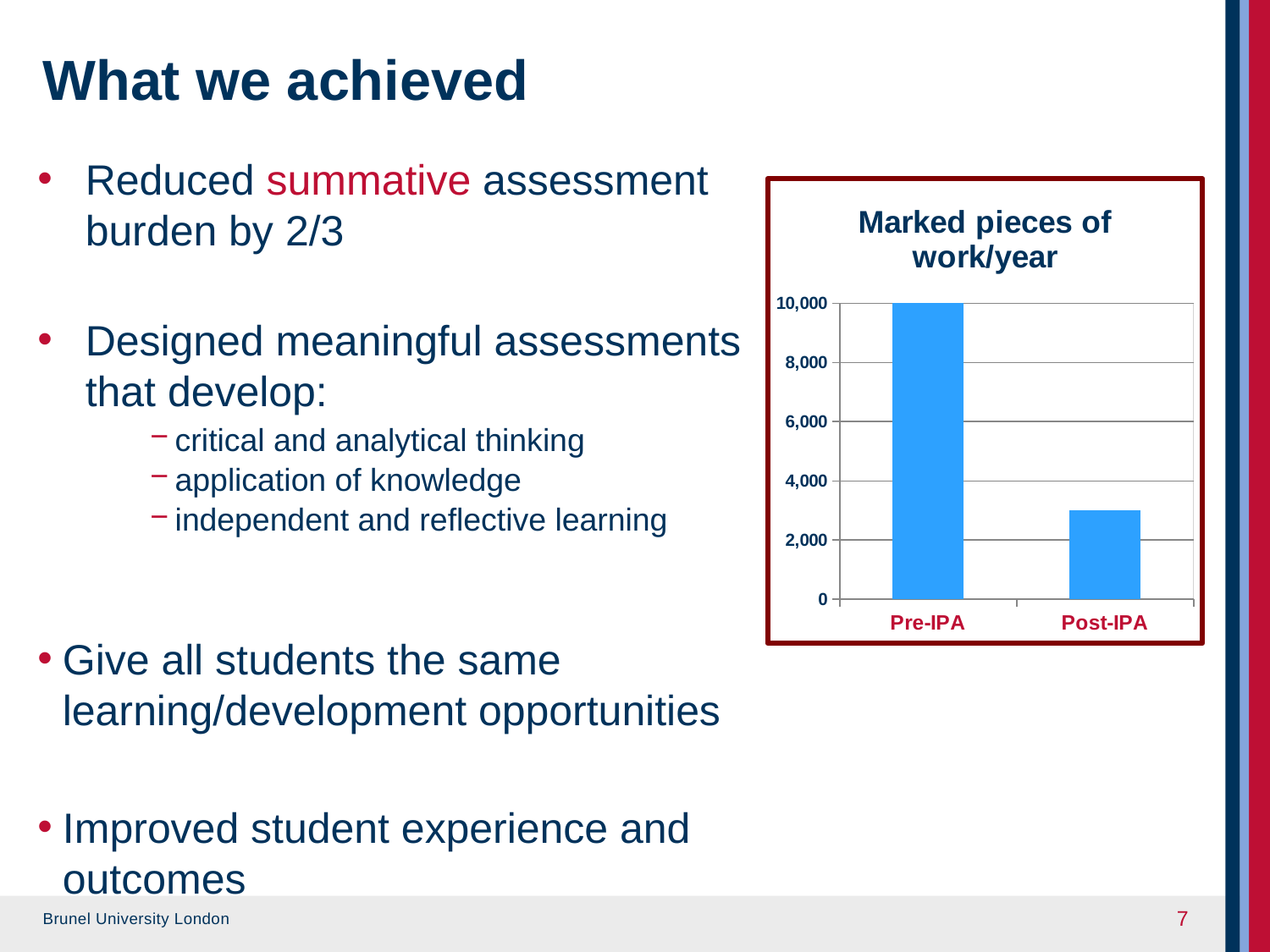
Is the value for Pre-IPA greater or less than 8,000? greater How many categories are shown on the x axis of the chart? 2 What is the title of the chart? Marked pieces of work/year Is the value for Post-IPA greater or less than 2,000? greater Which category has the highest value in the chart? Pre-IPA Which category has the lowest value in the chart? Post-IPA What type of chart is shown on the slide? bar chart What is the value for Pre-IPA in the chart? 10,000 Is the value for Post-IPA greater or less than 4,000? less Do the values rise or fall from Pre-IPA to Post-IPA? fall What colour are the bars in the chart? blue Which is larger, the value for Pre-IPA or the value for Post-IPA? Pre-IPA